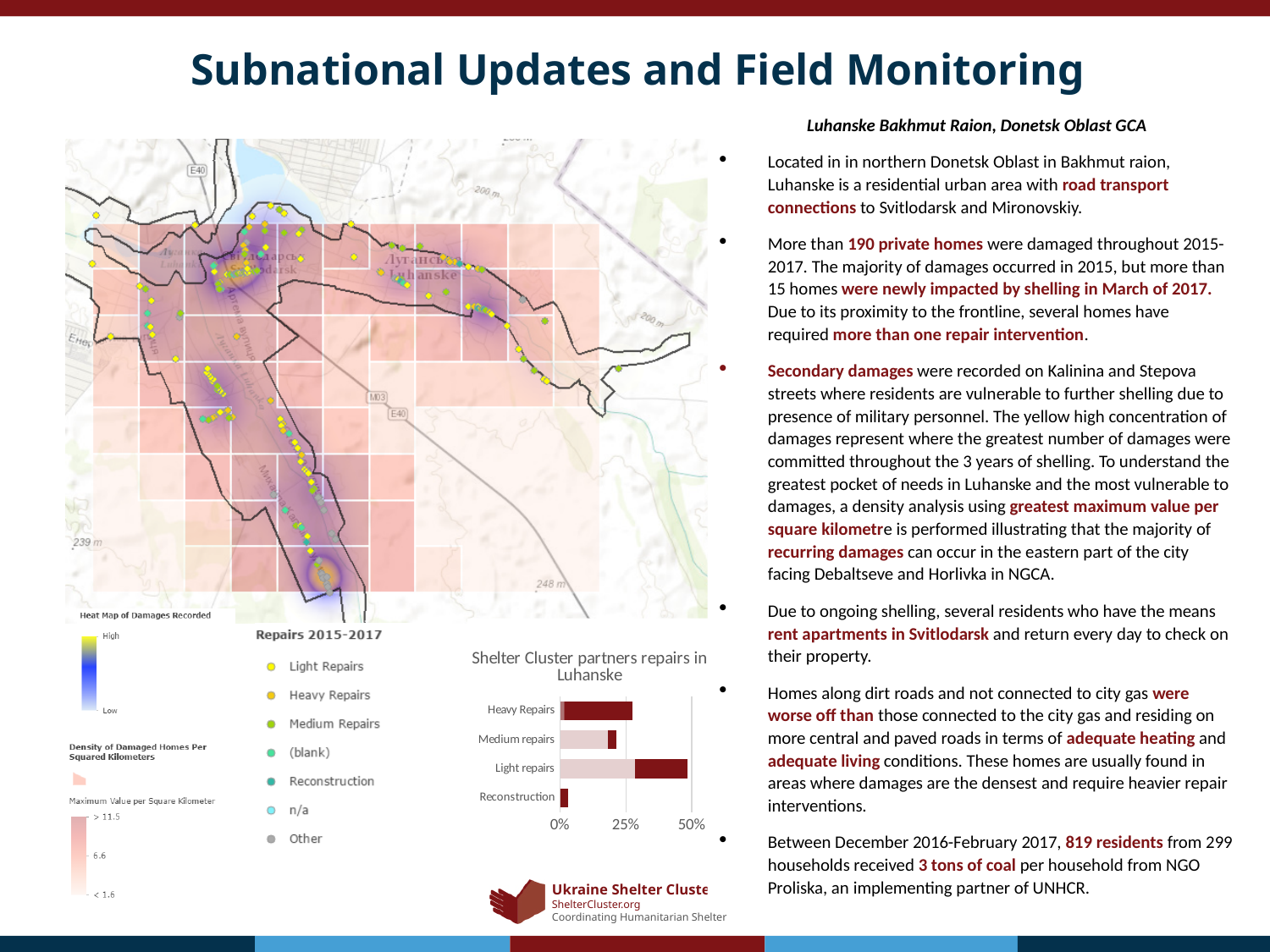
In the 'Shelter Cluster partners repairs in Luhanske' chart, is the total value for Medium repairs greater or less than 25%? less In the 'Shelter Cluster partners repairs in Luhanske' chart, which is larger: Heavy Repairs or Reconstruction? Heavy Repairs What kind of chart is the 'Shelter Cluster partners repairs in Luhanske' chart? bar chart In the 'Shelter Cluster partners repairs in Luhanske' chart, which category has the longest bar? Light repairs How many repair categories are shown in the 'Shelter Cluster partners repairs in Luhanske' chart? 4 In the 'Shelter Cluster partners repairs in Luhanske' chart, which category has the shortest bar? Reconstruction In the 'Shelter Cluster partners repairs in Luhanske' chart, is the total value for Light repairs greater or less than 25%? greater In the 'Shelter Cluster partners repairs in Luhanske' chart, which is larger: Light repairs or Medium repairs? Light repairs In the 'Shelter Cluster partners repairs in Luhanske' chart, is the value for Reconstruction greater or less than 25%? less What is the title of the bar chart on the slide? Shelter Cluster partners repairs in Luhanske What is the highest tick label shown on the horizontal axis of the 'Shelter Cluster partners repairs in Luhanske' chart? 50%